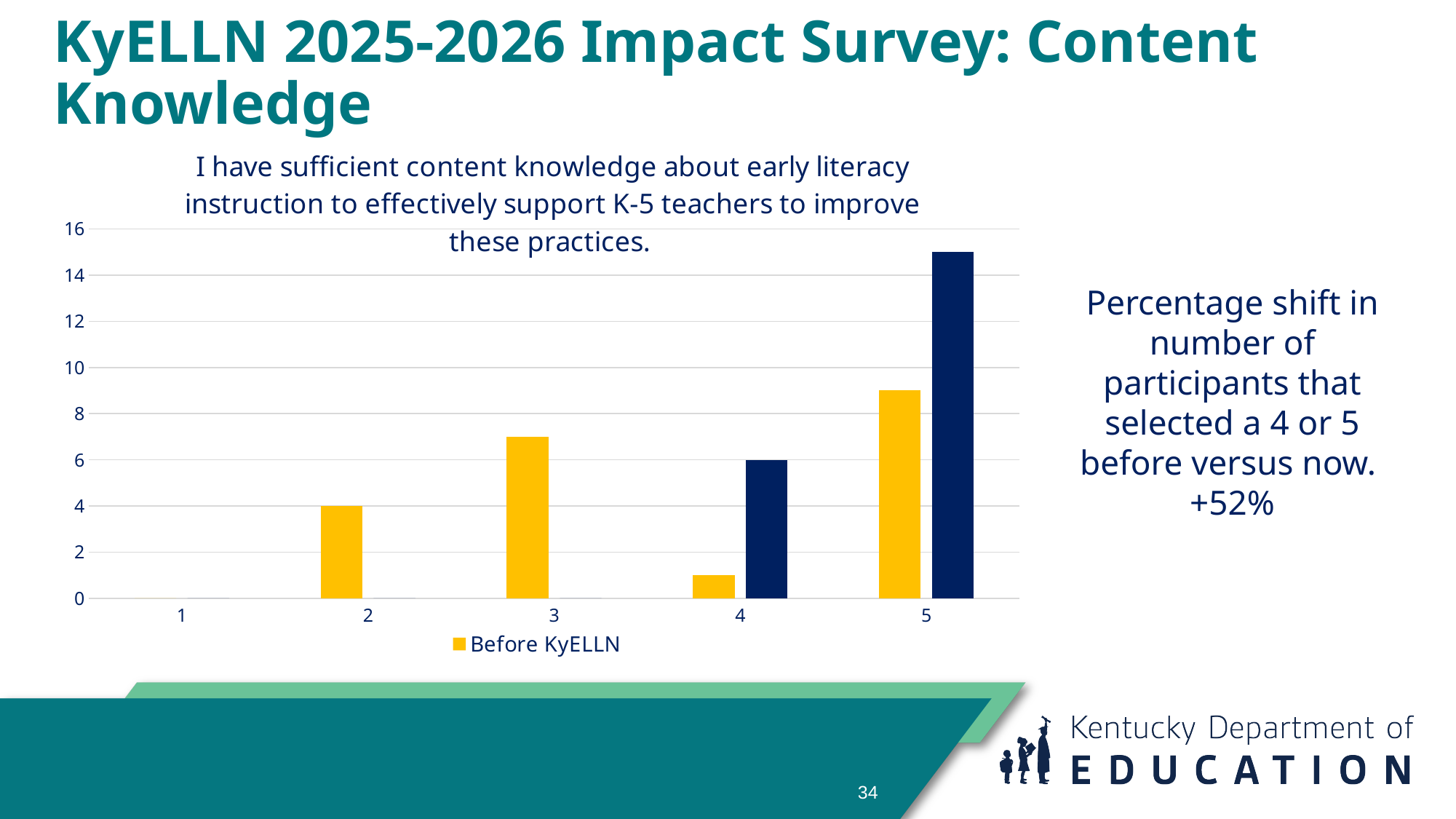
For category 5, which is larger: the Before KyELLN bar or the dark blue bar? The dark blue bar How many categories are shown on the x axis of the chart? 5 What is the Before KyELLN value for category 2? 4 What type of chart is shown on the slide? Bar chart Which category has the highest Before KyELLN value? 5 Is the Before KyELLN value for category 5 greater or less than 10? less What is the value of the dark blue bar for category 4? 6 What percentage shift in participants selecting a 4 or 5 is stated next to the chart? +52% Is the Before KyELLN value for category 3 greater or less than 6? greater Which category has the tallest dark blue bar? 5 Which series name is listed in the chart legend? Before KyELLN Is the value of the dark blue bar for category 5 greater or less than 14? greater